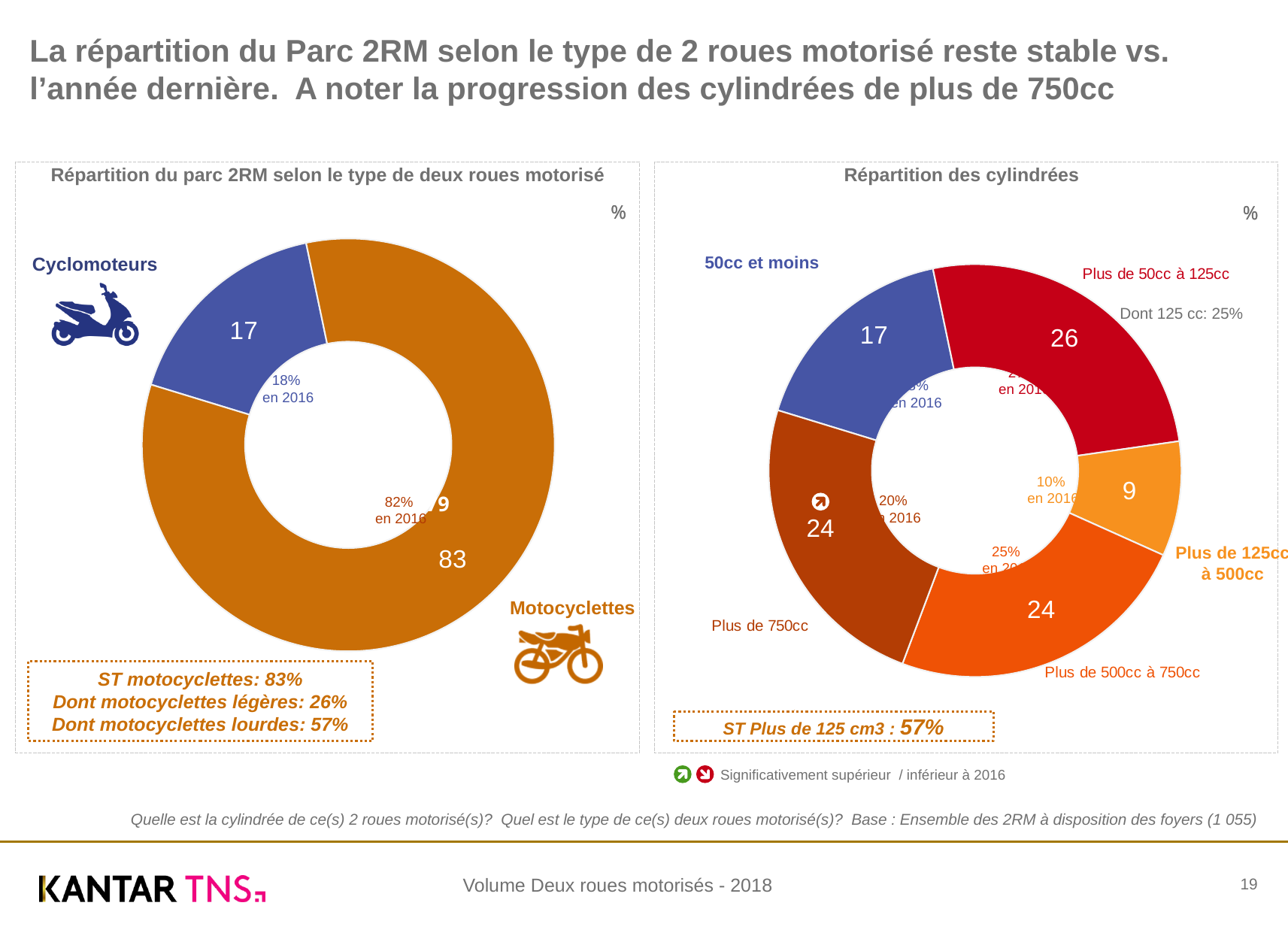
In the chart 'Répartition des cylindrées', what is the value for 'Plus de 50cc à 125cc'? 26 In the chart 'Répartition des cylindrées', which category has the largest share? Plus de 50cc à 125cc What kind of chart is 'Répartition du parc 2RM selon le type de deux roues motorisé'? Donut (pie) chart In the chart 'Répartition des cylindrées', what is the value for 'Plus de 750cc'? 24 In the chart 'Répartition du parc 2RM selon le type de deux roues motorisé', which category has the largest share? Motocyclettes In the chart 'Répartition des cylindrées', which is larger: '50cc et moins' or 'Plus de 500cc à 750cc'? Plus de 500cc à 750cc In the chart 'Répartition des cylindrées', how many categories are shown? 5 In the chart 'Répartition du parc 2RM selon le type de deux roues motorisé', what is the value for Cyclomoteurs? 17 In the chart 'Répartition des cylindrées', which category has the smallest share? Plus de 125cc à 500cc In the chart 'Répartition des cylindrées', what is the value for 'Plus de 125cc à 500cc'? 9 In the chart 'Répartition du parc 2RM selon le type de deux roues motorisé', what is the difference between the values for Motocyclettes and Cyclomoteurs? 66 In the chart 'Répartition du parc 2RM selon le type de deux roues motorisé', what is the value for Motocyclettes? 83